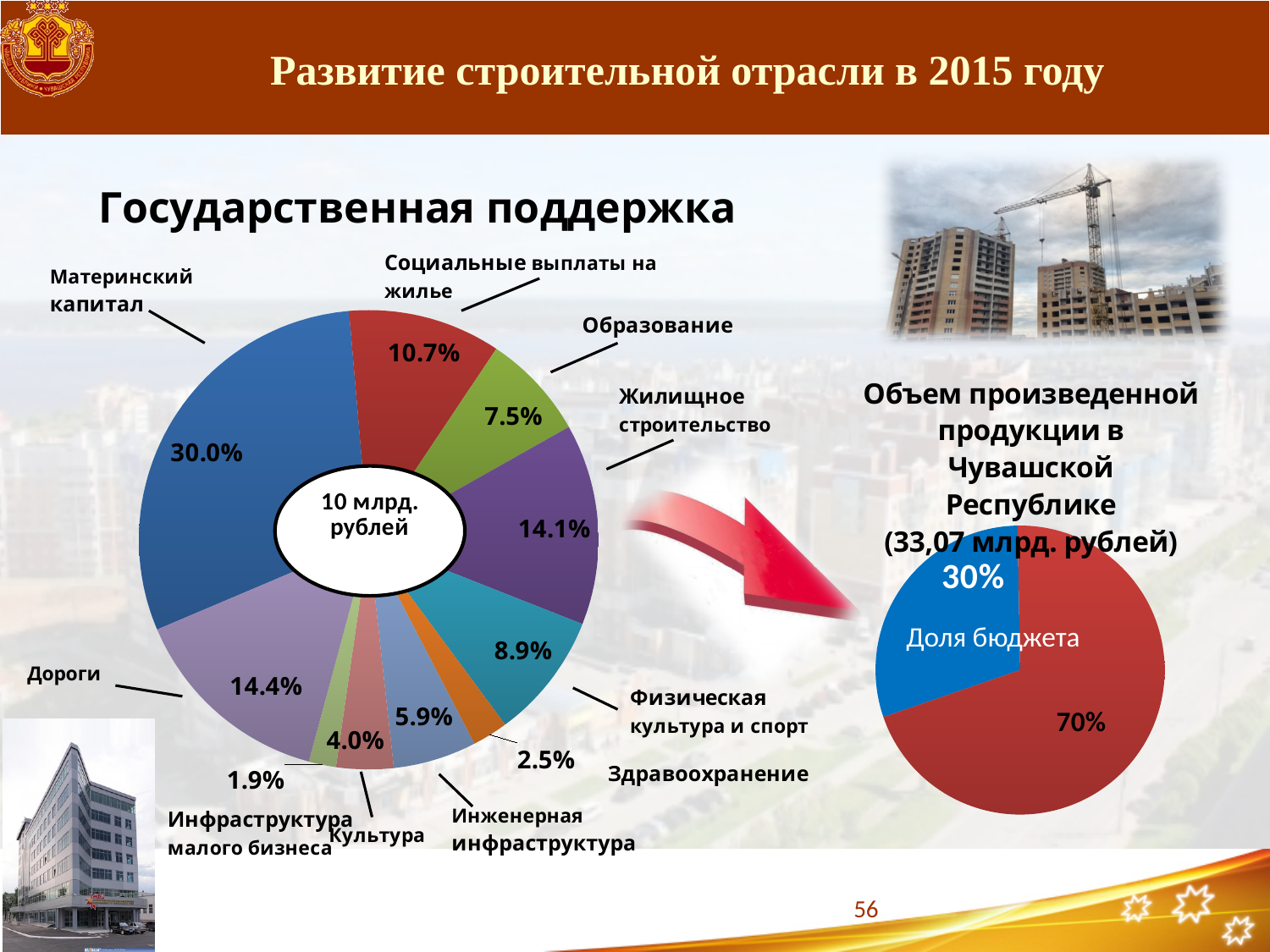
In the 'Государственная поддержка' pie chart, which category has the smallest share? Инфраструктура малого бизнеса How many slices does the 'Государственная поддержка' pie chart have? 10 In the 'Объем произведенной продукции в Чувашской Республике' pie chart, what share is labelled Доля бюджета? 30% In the 'Государственная поддержка' pie chart, what share is labelled for Здравоохранение? 2.5% What type of chart is used for 'Объем произведенной продукции в Чувашской Республике'? Pie chart In the 'Государственная поддержка' pie chart, which is larger: the share for Физическая культура и спорт or the share for Инженерная инфраструктура? Физическая культура и спорт In the 'Государственная поддержка' pie chart, which category has the largest share? Материнский капитал In the 'Государственная поддержка' pie chart, what share is labelled for Материнский капитал? 30.0% In the 'Государственная поддержка' pie chart, what share is labelled for Жилищное строительство? 14.1% What total amount is written in the centre of the 'Государственная поддержка' pie chart? 10 млрд. рублей In the 'Государственная поддержка' pie chart, what share is labelled for Дороги? 14.4% In the 'Государственная поддержка' pie chart, what is the difference between the shares for Социальные выплаты на жилье and Образование? 3.2%